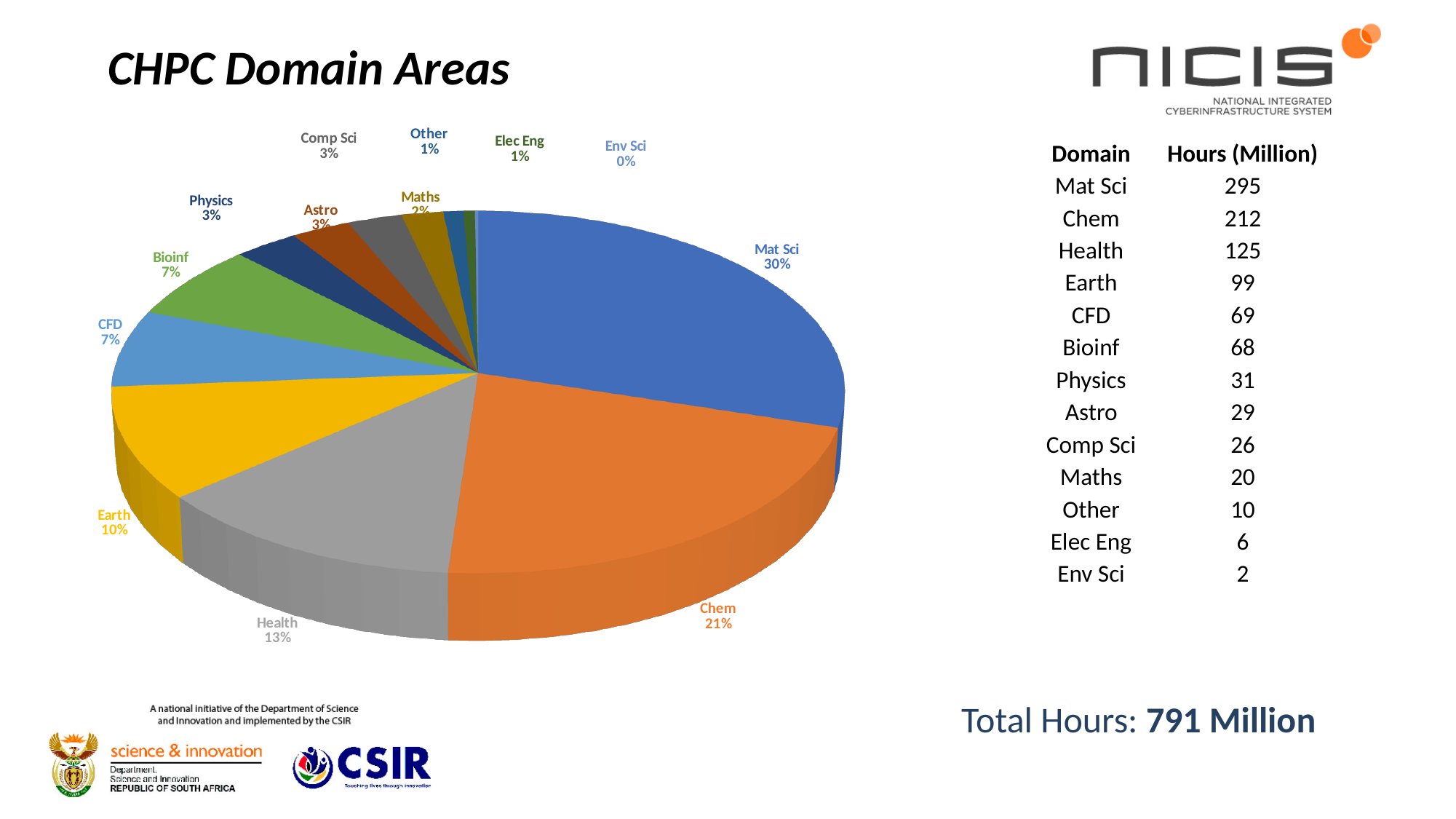
Which domain has the largest share of the pie? Mat Sci What is the title of the chart? CHPC Domain Areas Which has a larger share, Health or Earth? Health What percentage is shown for Health? 13% How many slices does the pie chart have? 13 What percentage is shown for Earth? 10% What share of the pie does Chem have? 21% What kind of chart is shown on the slide? Pie chart Which domain has the smallest share of the pie? Env Sci What percentage is shown for Maths? 2% What is the difference in percentage points between Mat Sci and Chem? 9 percentage points What percentage is shown for Bioinf? 7%